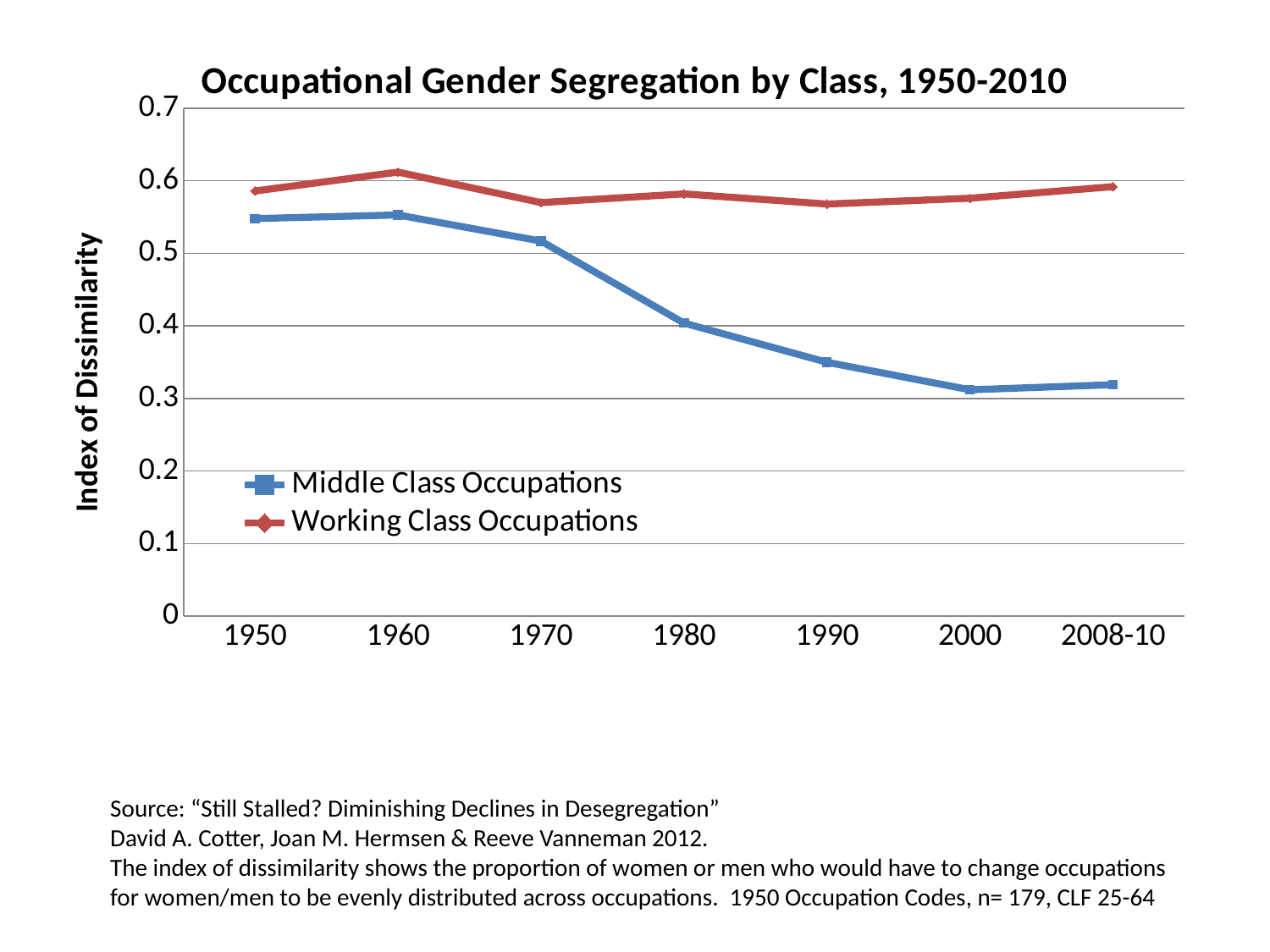
Does the Middle Class Occupations line overall rise or fall from 1950 to 2008-10? fall Is the value for Working Class Occupations in 2000 greater or less than 0.6? less Is the value for Working Class Occupations in 1960 greater or less than 0.6? greater Is the value for Middle Class Occupations in 1950 greater or less than 0.5? greater How many time points are shown along the x axis? 7 What is the title of the chart? Occupational Gender Segregation by Class, 1950-2010 What kind of chart is shown on the slide? line chart What is the label on the y axis? Index of Dissimilarity In 2000, which series has the larger value, Middle Class Occupations or Working Class Occupations? Working Class Occupations How many series does the legend list? 2 In which year does the Working Class Occupations line reach its highest value? 1960